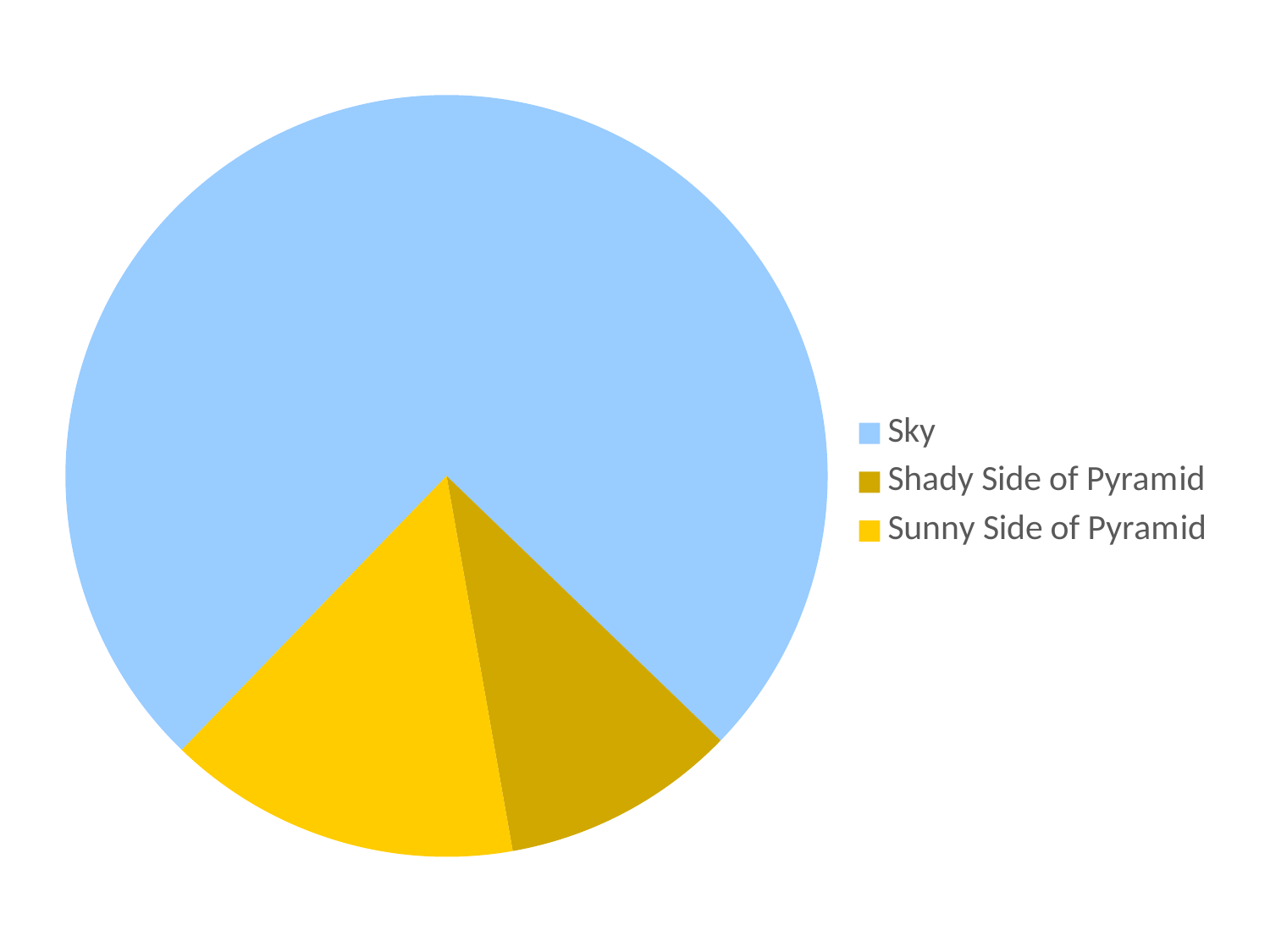
How many entries does the legend list? 3 What kind of chart is shown on the slide? Pie chart Which slice is larger, Sky or Sunny Side of Pyramid? Sky Which slice is larger, Sunny Side of Pyramid or Shady Side of Pyramid? Sunny Side of Pyramid Which legend entry is listed first? Sky How many slices does the pie chart have? 3 Which category has the smallest slice of the pie? Shady Side of Pyramid Which category has the largest slice of the pie? Sky What colour is the Sky slice? Light blue